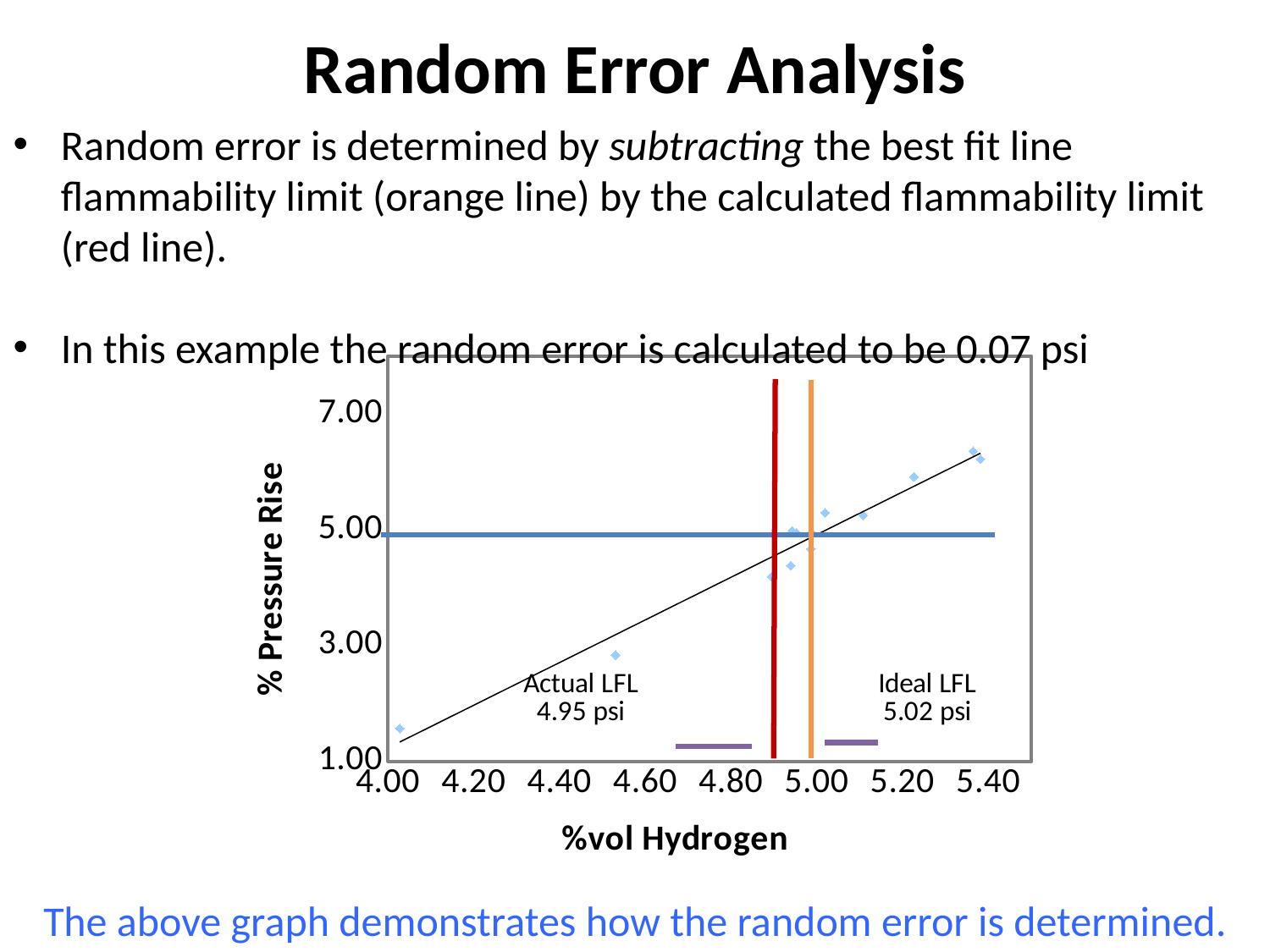
What is the title of the y axis of the chart? % Pressure Rise Is the % Pressure Rise for the data point at about 4.50 %vol Hydrogen greater or less than 3.00? less What kind of chart is shown on the slide? scatter chart Do the plotted data points rise or fall as %vol Hydrogen increases? rise Is the % Pressure Rise for the data point at about 4.00 %vol Hydrogen greater or less than 3.00? less What is the title of the x axis of the chart? %vol Hydrogen What value is labelled for the Ideal LFL on the chart? 5.02 psi What value is labelled for the Actual LFL on the chart? 4.95 psi What is the difference between the Ideal LFL and the Actual LFL values shown on the chart? 0.07 psi Is the % Pressure Rise for the data points near 5.40 %vol Hydrogen greater or less than 5.00? greater Which is larger, the Ideal LFL value or the Actual LFL value? Ideal LFL